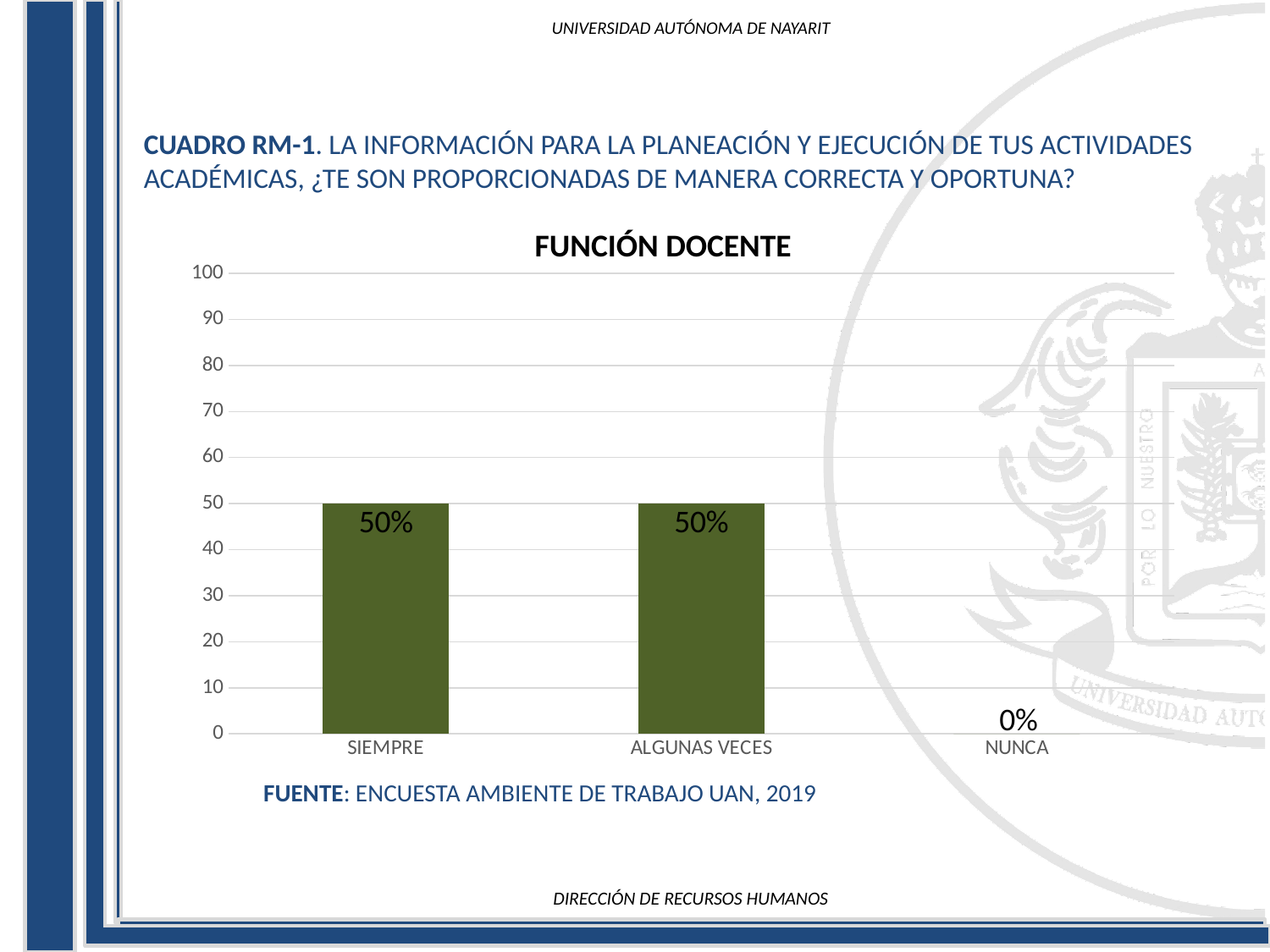
Which is larger, the value for ALGUNAS VECES or the value for NUNCA? ALGUNAS VECES What is the title of the chart? FUNCIÓN DOCENTE Is the value for SIEMPRE greater or less than 60? less Do the values for SIEMPRE and ALGUNAS VECES differ? No, both are 50% What kind of chart is shown? bar chart What is the difference between the values for SIEMPRE and NUNCA? 50% How many categories are shown on the x axis? 3 What is the value for NUNCA? 0% What is the value for ALGUNAS VECES? 50% What is the highest value shown on the y axis? 100 Which category has the lowest value? NUNCA What is the value for SIEMPRE? 50%